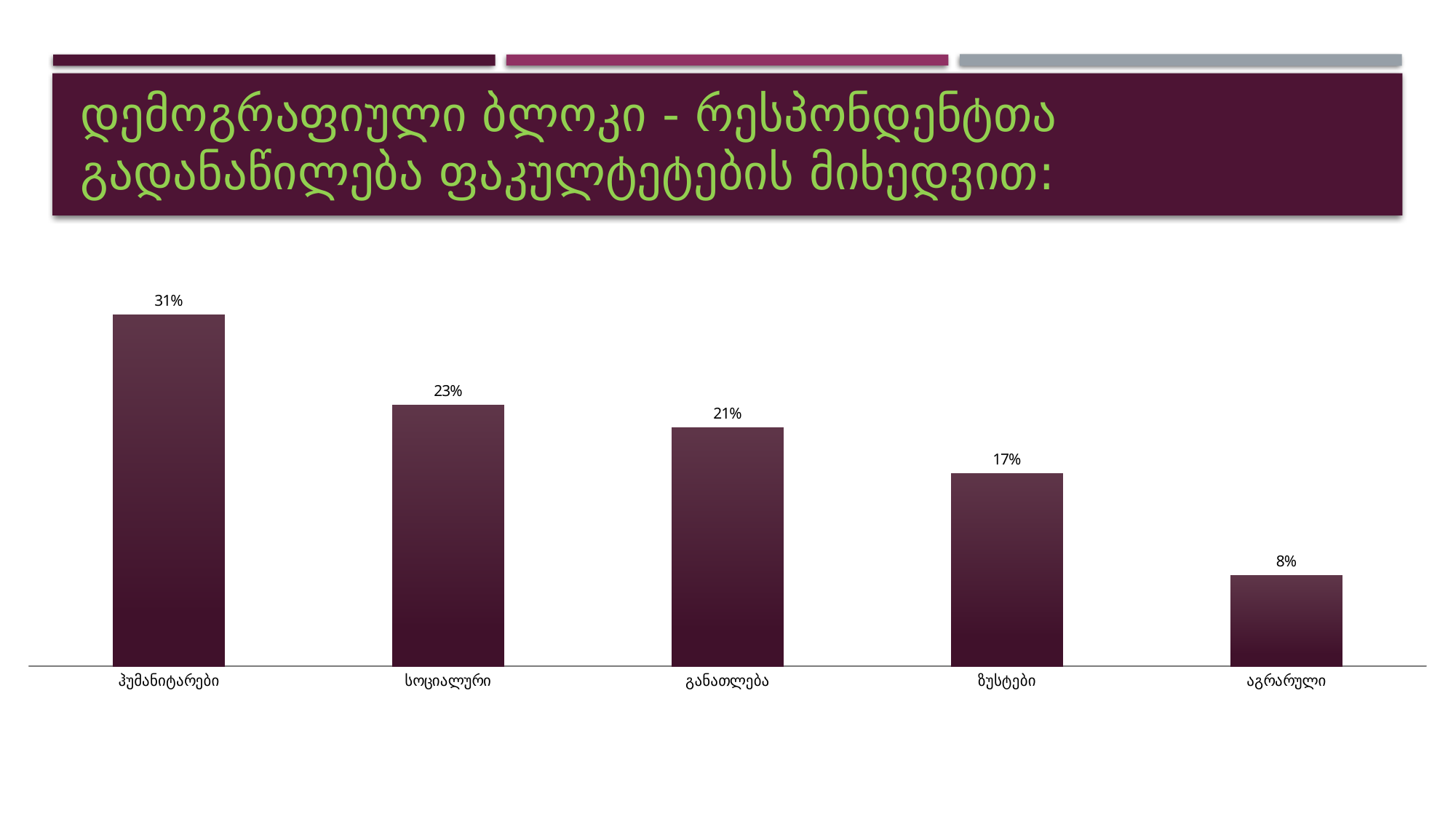
Which category has the lowest value? აგრარული What is the value for აგრარული? 8% What is the value for განათლება? 21% How many categories are shown in the chart? 5 What is the value for ჰუმანიტარები? 31% What kind of chart is shown on the slide? Bar chart What is the value for ზუსტები? 17% What is the difference between the values for ჰუმანიტარები and აგრარული? 23% Which is larger, the value for სოციალური or the value for ზუსტები? სოციალური What is the value for სოციალური? 23% What is the difference between the values for სოციალური and ზუსტები? 6% Which category has the highest value? ჰუმანიტარები